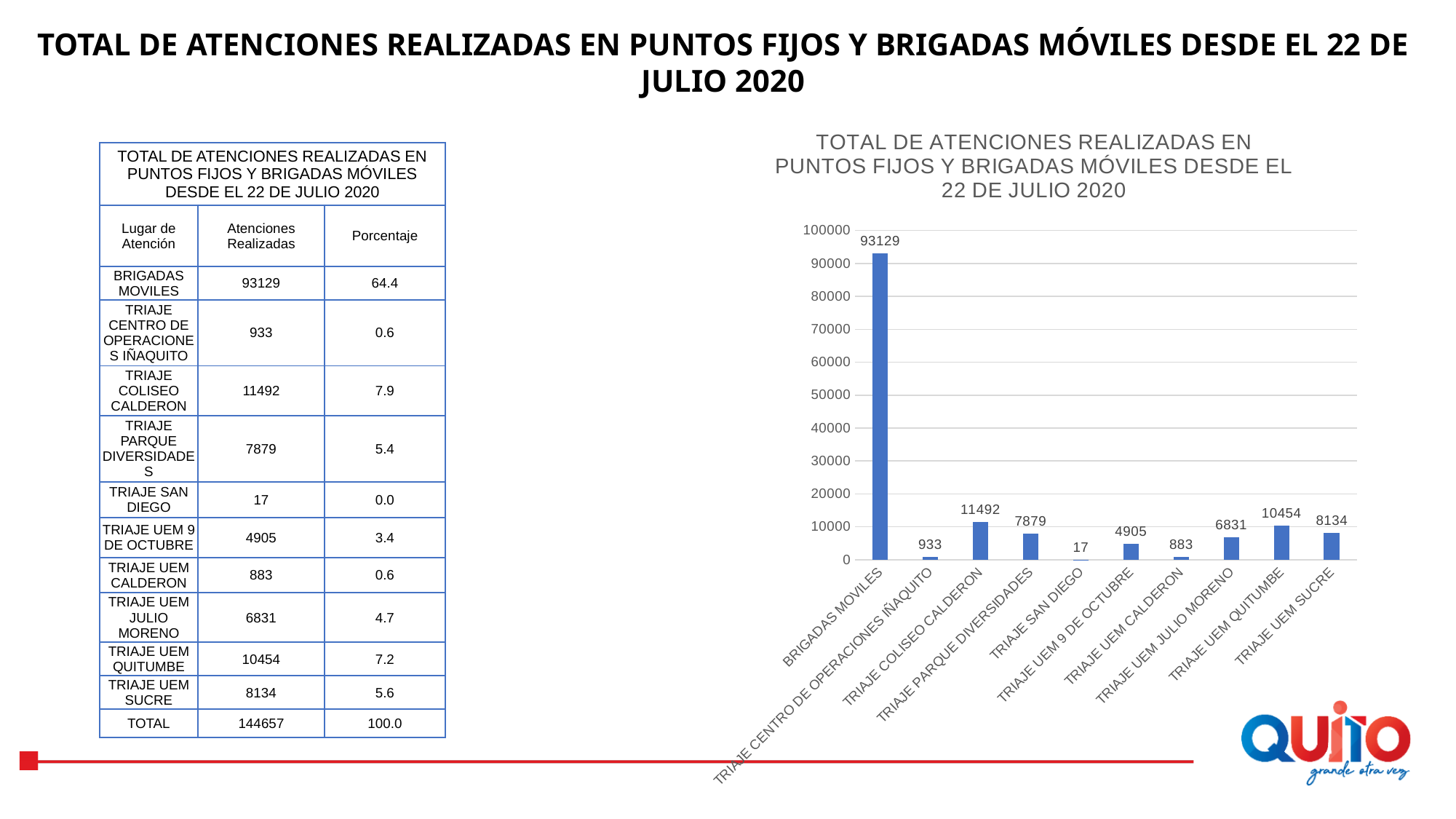
What is the value for TRIAJE UEM QUITUMBE in the chart? 10454 What is the title of the chart? TOTAL DE ATENCIONES REALIZADAS EN PUNTOS FIJOS Y BRIGADAS MÓVILES DESDE EL 22 DE JULIO 2020 Which is larger, the value for TRIAJE UEM SUCRE or the value for TRIAJE UEM 9 DE OCTUBRE? TRIAJE UEM SUCRE What is the difference between the values for TRIAJE COLISEO CALDERON and TRIAJE PARQUE DIVERSIDADES? 3613 Is the value for TRIAJE COLISEO CALDERON greater or less than 10000? greater Which category has the highest value in the chart? BRIGADAS MOVILES How many categories are shown in the chart? 10 What kind of chart is shown on the slide? bar chart What is the value for TRIAJE SAN DIEGO in the chart? 17 Which category has the lowest value in the chart? TRIAJE SAN DIEGO What is the value for TRIAJE UEM JULIO MORENO in the chart? 6831 What is the value for BRIGADAS MOVILES in the chart? 93129